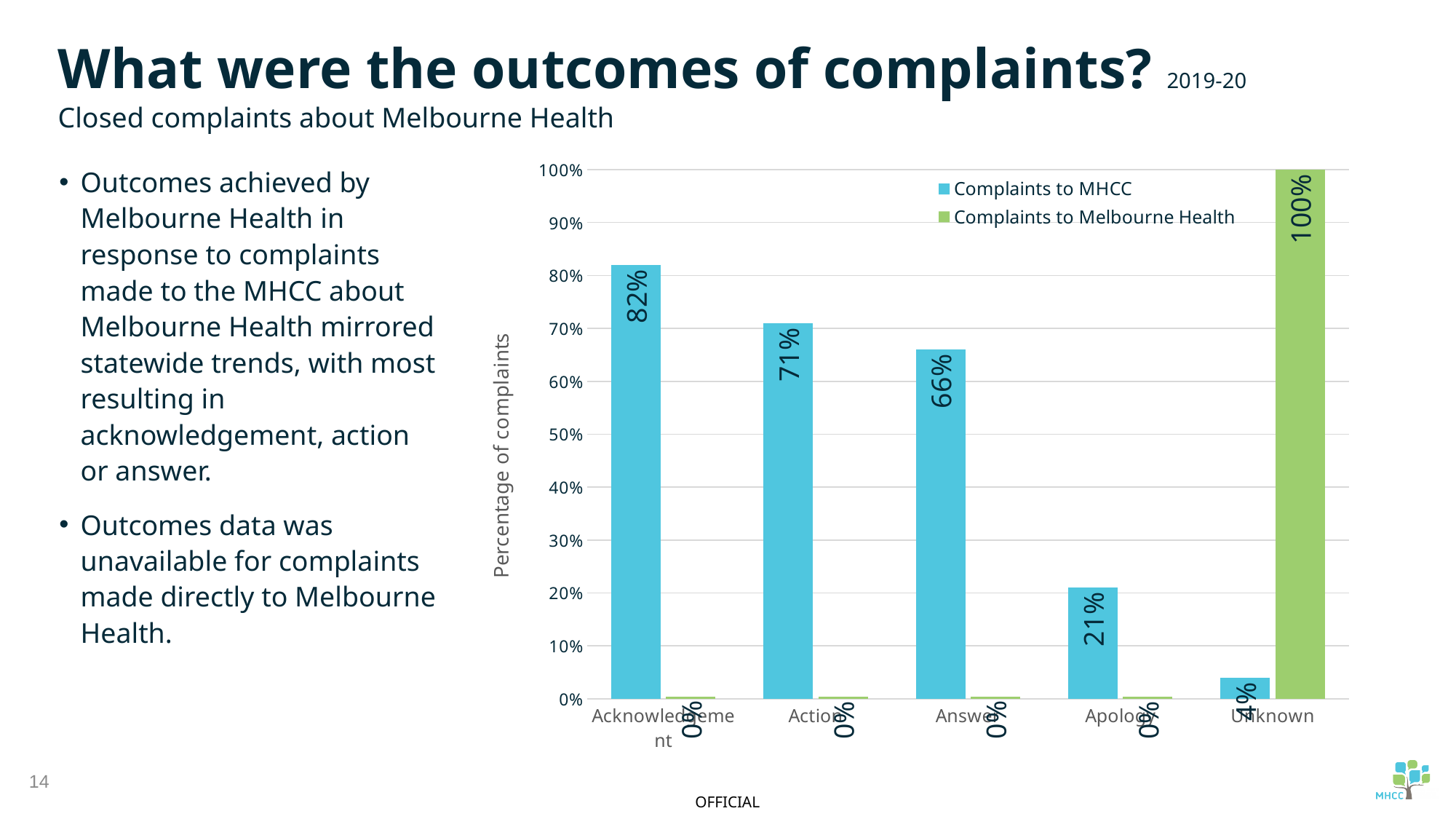
What type of chart is shown on the slide? Bar chart What percentage of complaints to MHCC resulted in Action? 71% What percentage of complaints to MHCC resulted in Acknowledgement? 82% Which outcome category has the highest value for Complaints to MHCC? Acknowledgement How many series does the legend list? 2 How many outcome categories are shown on the x axis? 5 Which outcome category has the lowest value for Complaints to MHCC? Unknown What percentage of complaints to MHCC resulted in an Apology? 21% Is the value for Answer for Complaints to MHCC greater or less than 60%? greater For Complaints to MHCC, which is larger: Action or Apology? Action What is the difference between the Acknowledgement and Answer values for Complaints to MHCC? 16% What percentage of complaints to Melbourne Health have an Unknown outcome? 100%